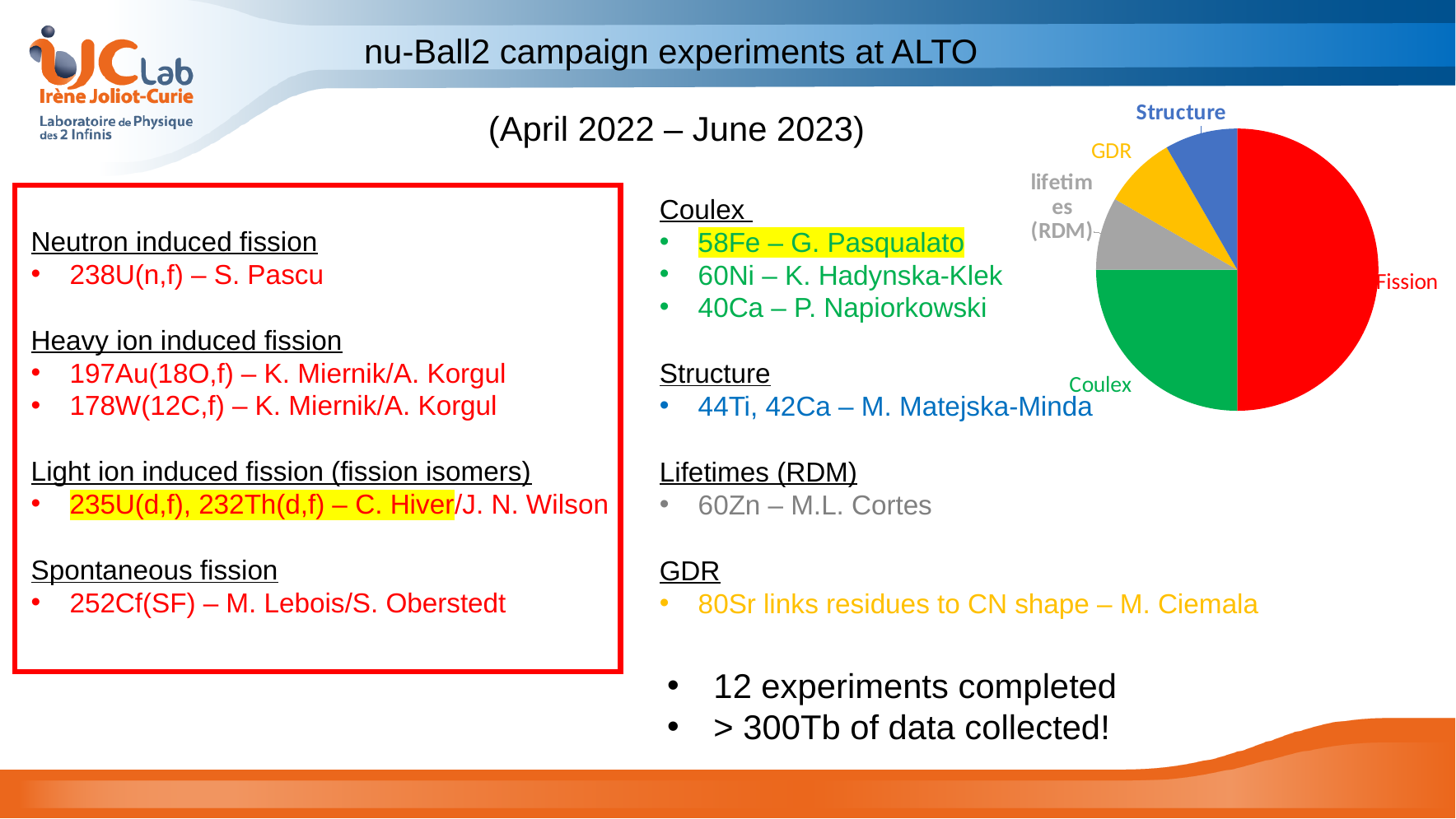
Which category has the largest slice in the pie chart? Fission Which category has the second-largest slice in the pie chart? Coulex What colour is the Fission slice in the pie chart? red Which is larger in the pie chart, Coulex or GDR? Coulex How many slices does the pie chart have? 5 What colour is the Coulex slice in the pie chart? green Which is larger in the pie chart, Coulex or lifetimes (RDM)? Coulex Which is larger in the pie chart, Fission or Coulex? Fission What kind of chart is shown on the slide? pie chart